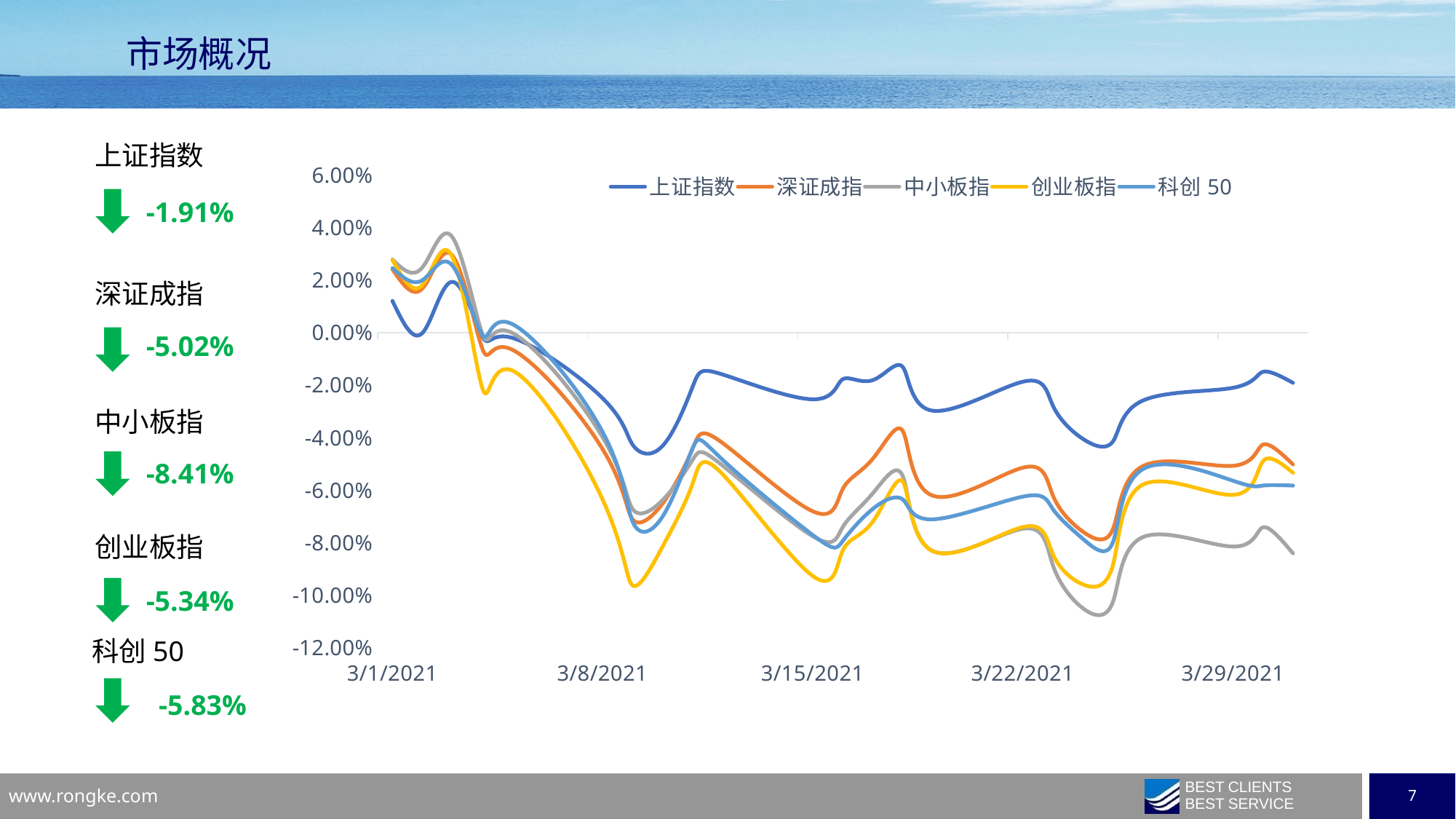
Which series reaches the lowest point anywhere on the chart? 中小板指 Is the value for 上证指数 at 3/22/2021 greater or less than -4.00%? greater At 3/29/2021, which is higher: 上证指数 or 中小板指? 上证指数 What kind of chart is shown on the slide? line chart Which colour is used for the 创业板指 line in the chart? yellow Overall, do the series values rise or fall from 3/1/2021 to the end of the chart? fall Is the value for 中小板指 at 3/29/2021 greater or less than -6.00%? less What is the title of the slide containing the chart? 市场概况 How many series does the chart legend list? 5 Is the value for 创业板指 at 3/8/2021 greater or less than -2.00%? less Which series reaches the highest point anywhere on the chart? 中小板指